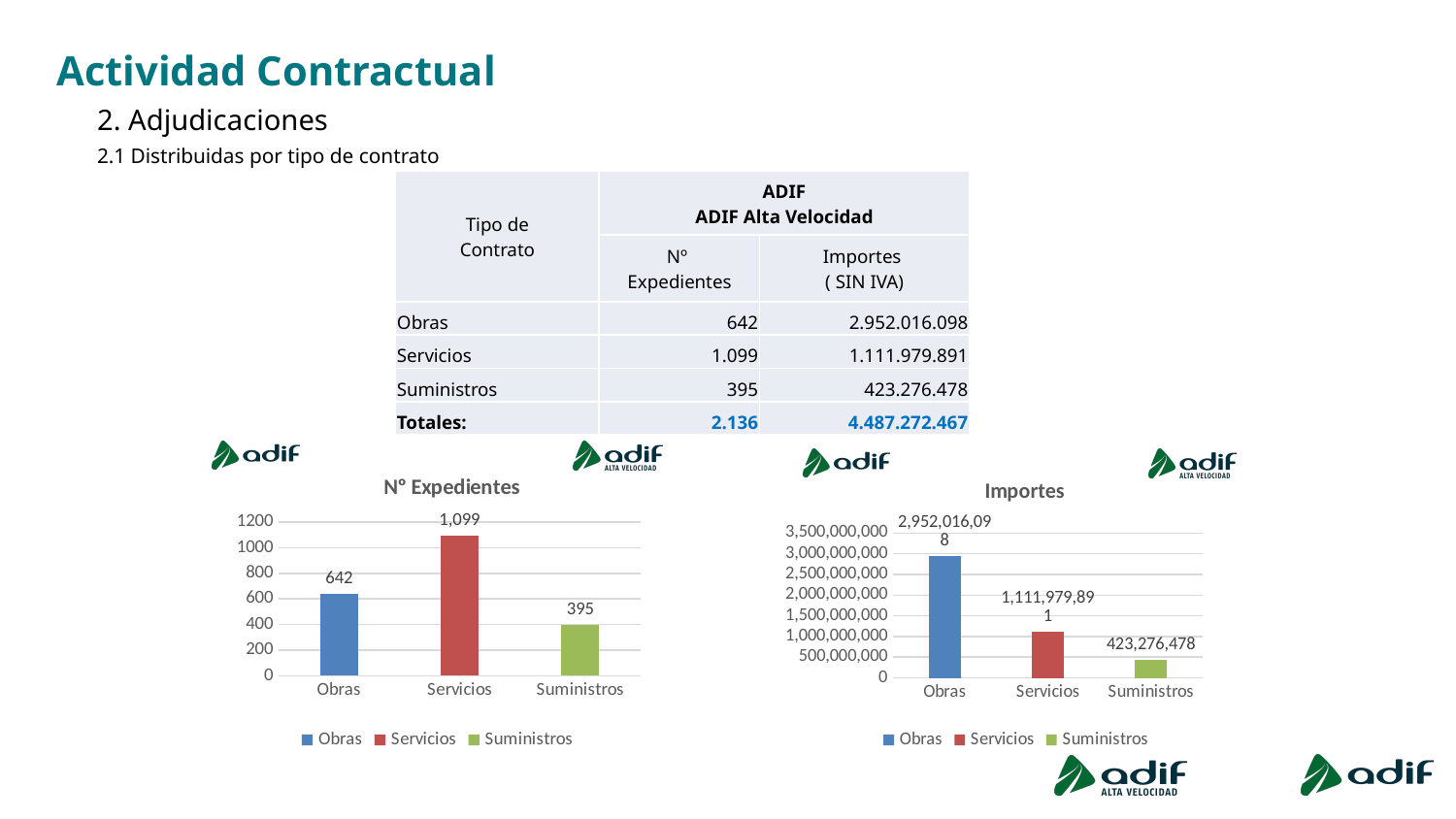
In the 'Importes' chart, what is the value for Obras? 2,952,016,098 In the 'Nº Expedientes' chart, which category has the lowest value? Suministros In the 'Nº Expedientes' chart, which category has the highest value? Servicios In the 'Nº Expedientes' chart, what is the value for Servicios? 1,099 In the 'Importes' chart, which is larger, Servicios or Suministros? Servicios In the 'Nº Expedientes' chart, what is the value for Suministros? 395 In the 'Importes' chart, what is the value for Suministros? 423,276,478 How many categories are shown in the 'Nº Expedientes' chart? 3 In the 'Importes' chart, which category has the highest value? Obras In the 'Nº Expedientes' chart, what is the difference between Servicios and Obras? 457 In the 'Importes' chart, is the value for Servicios greater or less than 1,000,000,000? greater What type of chart is the 'Importes' chart? Bar chart